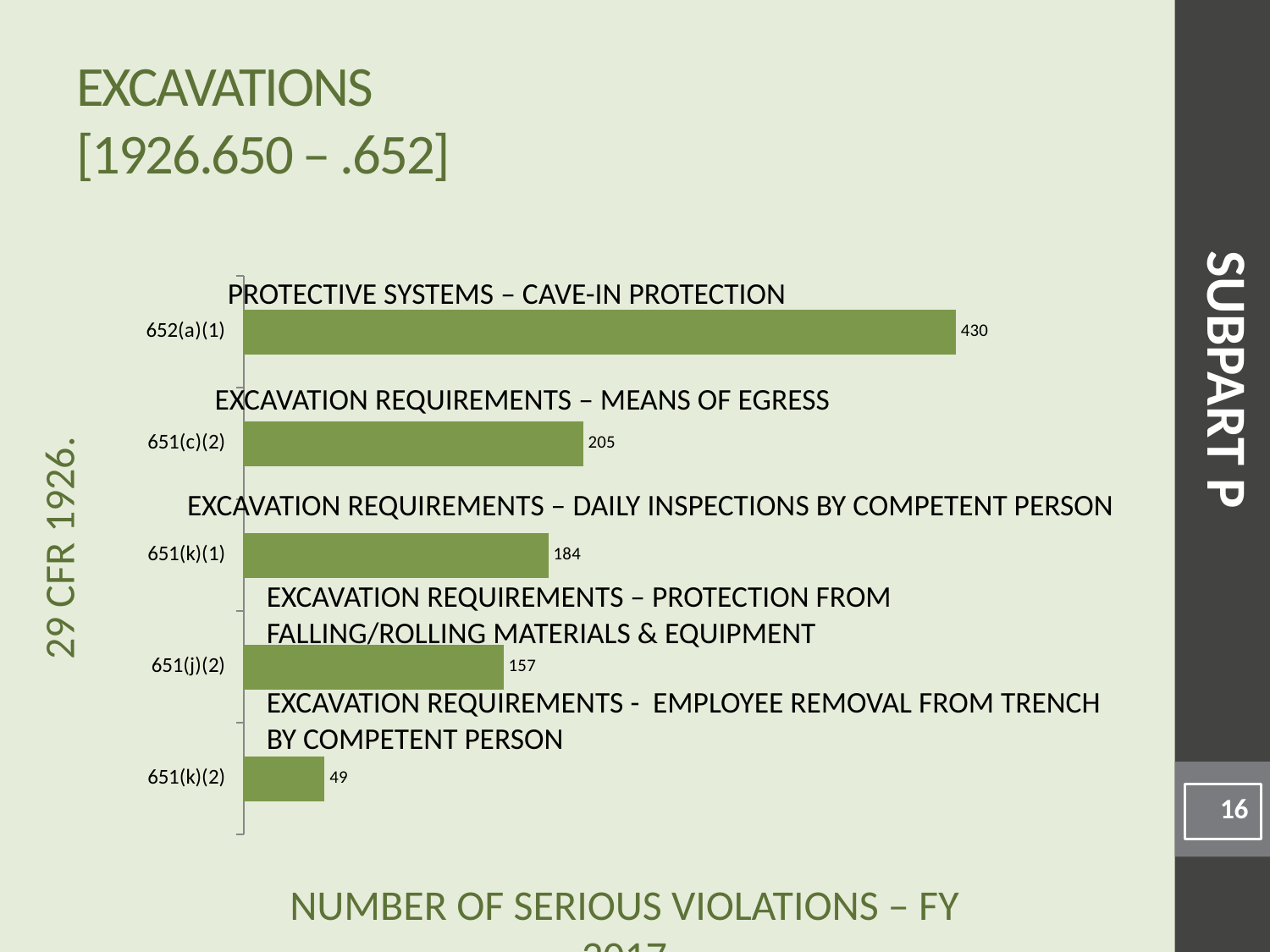
Which standard has the lowest number of serious violations? 651(k)(2) Which standard has the highest number of serious violations? 652(a)(1) What is the number of serious violations for 651(k)(2)? 49 What is the number of serious violations for 651(k)(1)? 184 Which has more serious violations, 651(k)(1) or 651(j)(2)? 651(k)(1) Which standard is labelled 'PROTECTIVE SYSTEMS – CAVE-IN PROTECTION'? 652(a)(1) What kind of chart is shown on the slide? Bar chart How many standards are shown in the chart? 5 What is the number of serious violations for 651(c)(2)? 205 What is the difference between the violations for 652(a)(1) and 651(c)(2)? 225 What is the number of serious violations for 652(a)(1)? 430 What is the number of serious violations for 651(j)(2)? 157